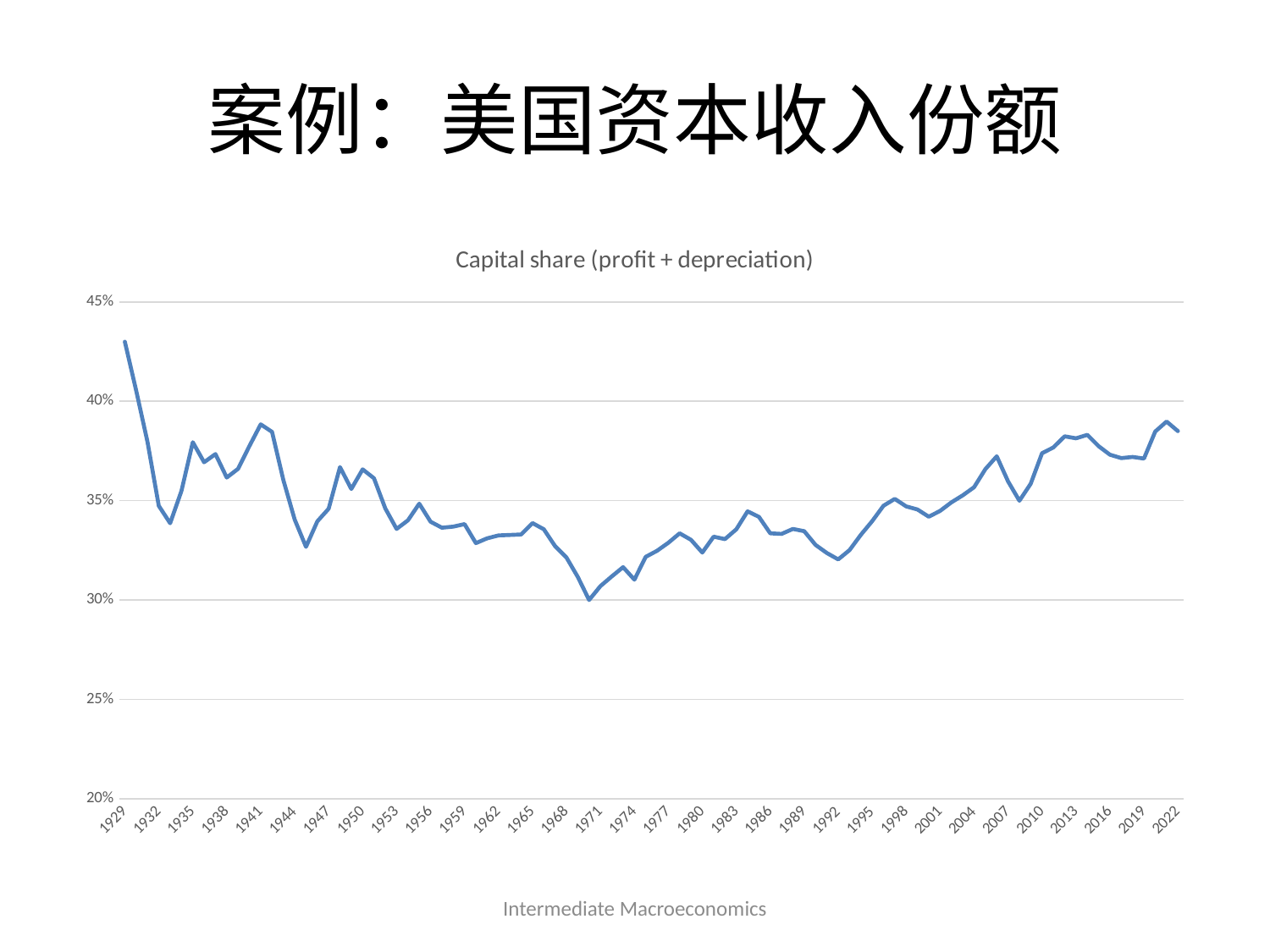
Which year has the larger capital share, 1971 or 2007? 2007 Does the capital share rise or fall from 1992 to 2022 overall? rise Is the value for 2022 greater or less than 35%? greater What kind of chart is shown on the slide? line chart In which year is the capital share lowest? 1970 Is the value for 1929 greater or less than 40%? greater Which year has the larger capital share, 1929 or 2022? 1929 Is the value for 1971 greater or less than 35%? less In which year is the capital share highest? 1929 What is the title of the chart? Capital share (profit + depreciation)